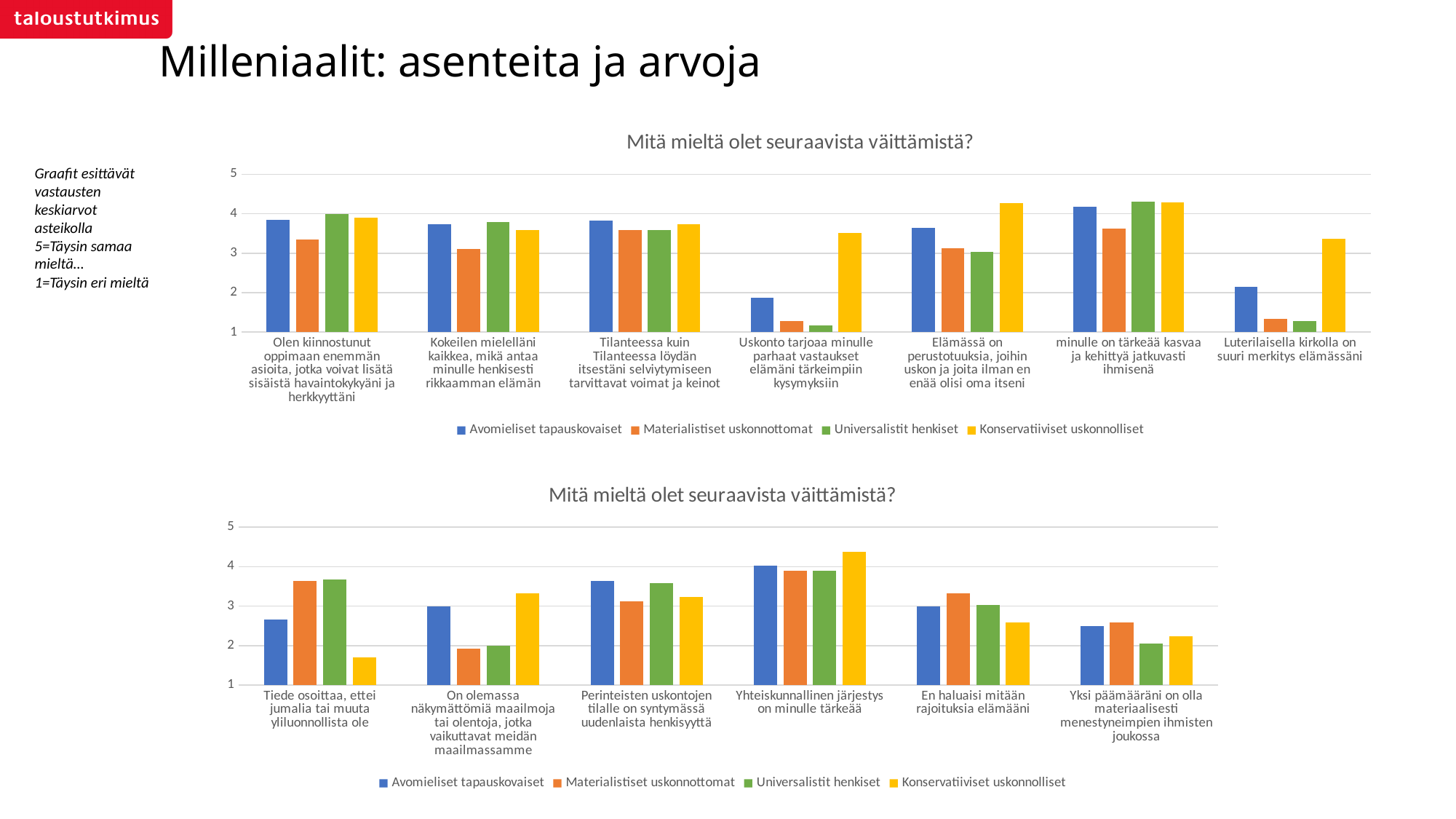
How many statements (categories) are shown on the x axis of the bottom chart? 6 In the top chart, which series has the highest value for the statement 'Uskonto tarjoaa minulle parhaat vastaukset elämäni tärkeimpiin kysymyksiin'? Konservatiiviset uskonnolliset In the top chart, for the statement 'Uskonto tarjoaa minulle parhaat vastaukset elämäni tärkeimpiin kysymyksiin', which is larger: Avomieliset tapauskovaiset or Konservatiiviset uskonnolliset? Konservatiiviset uskonnolliset In the bottom chart, which series has the lowest value for the statement 'Tiede osoittaa, ettei jumalia tai muuta yliluonnollista ole'? Konservatiiviset uskonnolliset What kind of chart is the top chart on the slide? bar chart In the bottom chart, which series has the highest value for the statement 'On olemassa näkymättömiä maailmoja tai olentoja, jotka vaikuttavat meidän maailmassamme'? Konservatiiviset uskonnolliset How many series does the legend of the bottom chart list? 4 How many statements (categories) are shown on the x axis of the top chart? 7 In the bottom chart, is the value of Konservatiiviset uskonnolliset for 'Yhteiskunnallinen järjestys on minulle tärkeää' greater or less than 4? greater In the top chart, is the value of Konservatiiviset uskonnolliset for 'Luterilaisella kirkolla on suuri merkitys elämässäni' greater or less than 3? greater In the top chart, which series has the lowest value for the statement 'minulle on tärkeää kasvaa ja kehittyä jatkuvasti ihmisenä'? Materialistiset uskonnottomat What is the title of the bottom chart? Mitä mieltä olet seuraavista väittämistä?